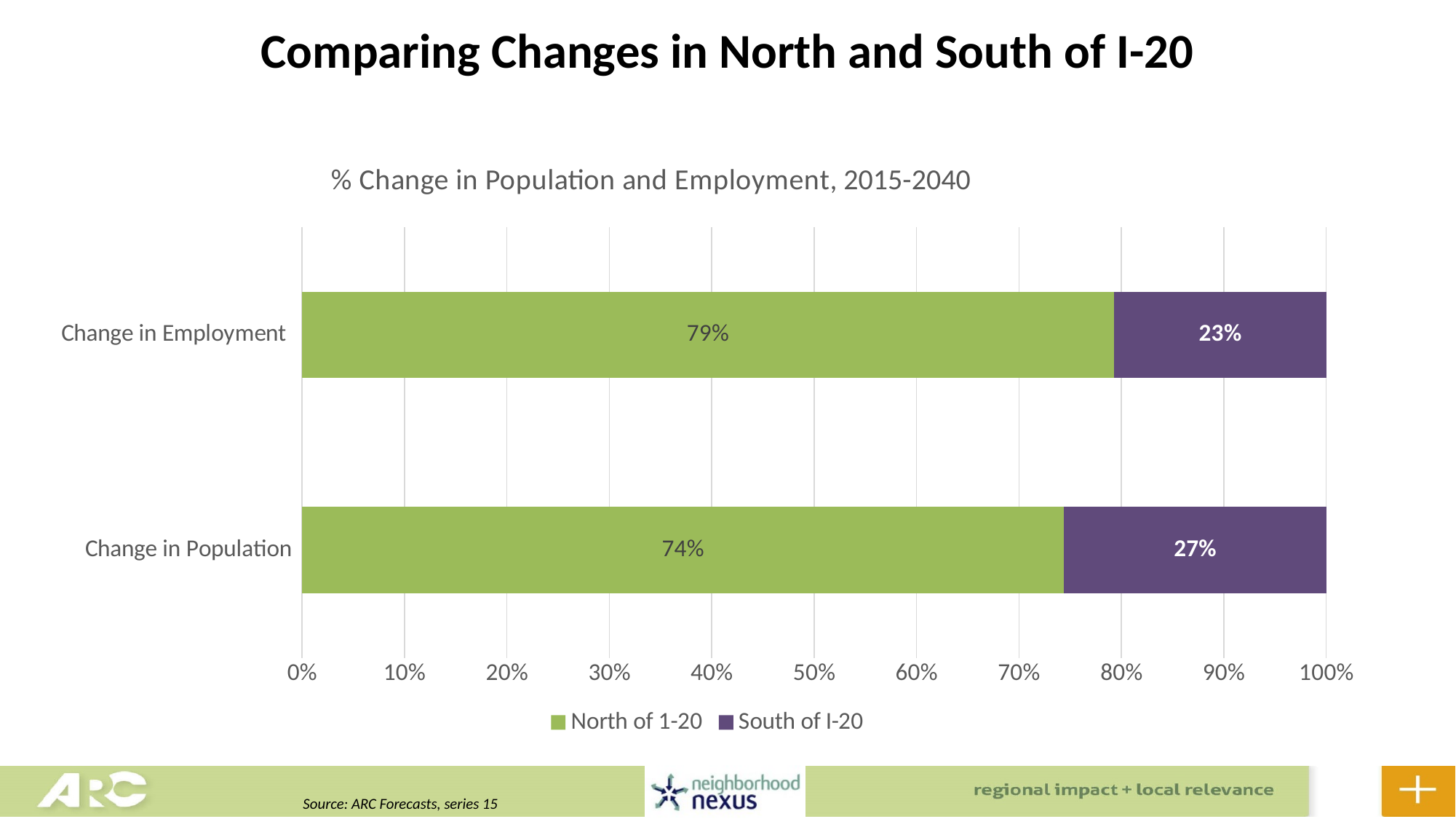
Which category has the lower South of I-20 value? Change in Employment How many categories are shown on the chart? 2 What is the value for North of 1-20 in the Change in Employment bar? 79% What is the value for South of I-20 in the Change in Population bar? 27% What is the difference between the North of 1-20 values for Change in Employment and Change in Population? 5% What is the value for South of I-20 in the Change in Employment bar? 23% What is the difference between the South of I-20 values for Change in Population and Change in Employment? 4% What is the title of the chart? % Change in Population and Employment, 2015-2040 Which category has the higher North of 1-20 value, Change in Employment or Change in Population? Change in Employment What is the value for North of 1-20 in the Change in Population bar? 74% How many series does the legend list? 2 What kind of chart is shown on the slide? Stacked bar chart